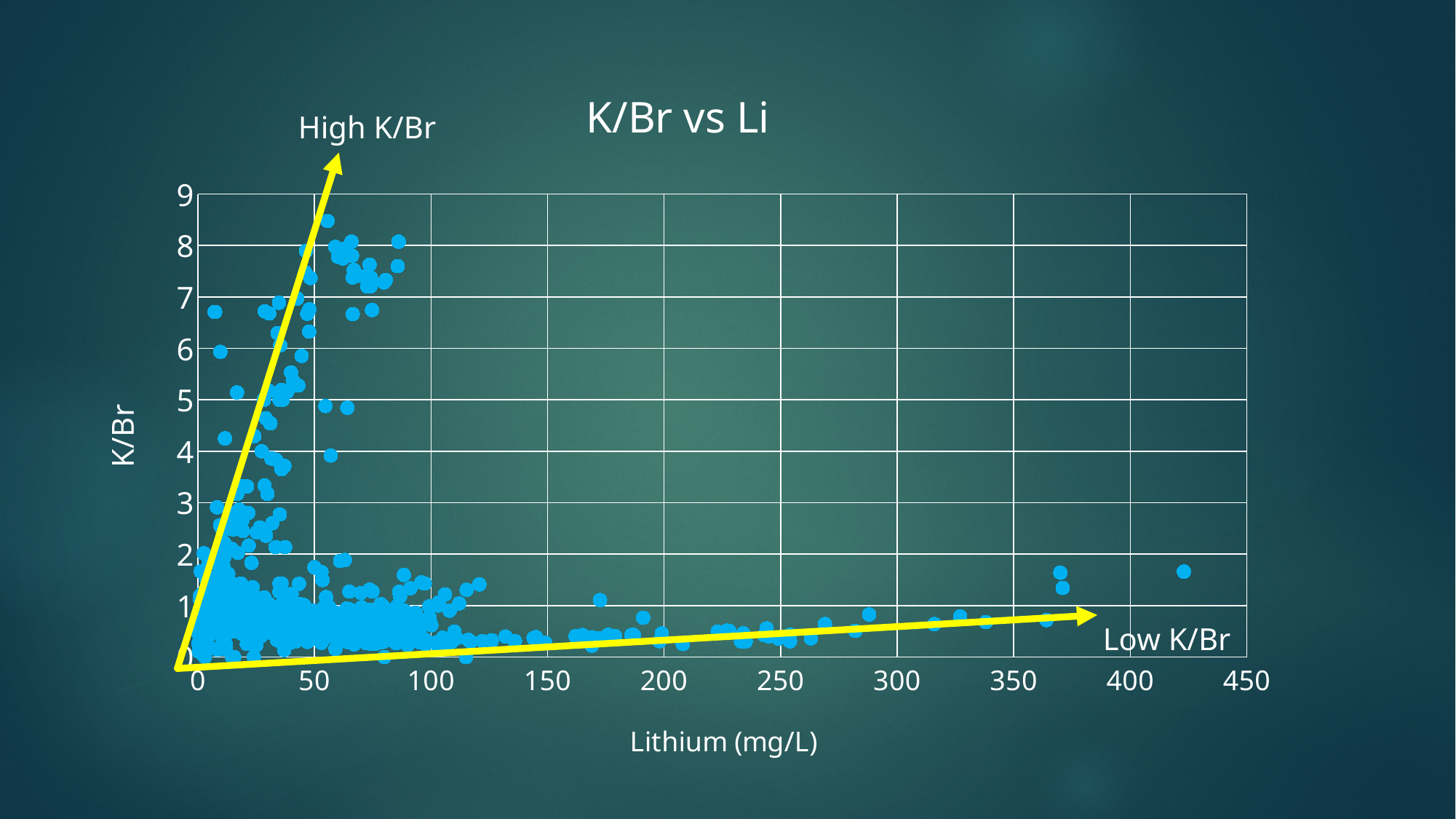
What is the highest value shown on the y axis (K/Br) of the chart? 9 Is the highest K/Br value plotted on the chart greater or less than 8? greater What is the title of the chart? K/Br vs Li Is the K/Br value of the point plotted near 175 mg/L lithium greater or less than 2? less What labels do the two yellow arrows on the chart carry? High K/Br and Low K/Br What is the interval between consecutive tick marks on the x axis of the chart? 50 What kind of chart is shown on the slide? scatter plot Is the K/Br value of the rightmost point on the chart greater or less than 2? less What is the highest value shown on the x axis (Lithium) of the chart? 450 How many data series are plotted on the chart? 1